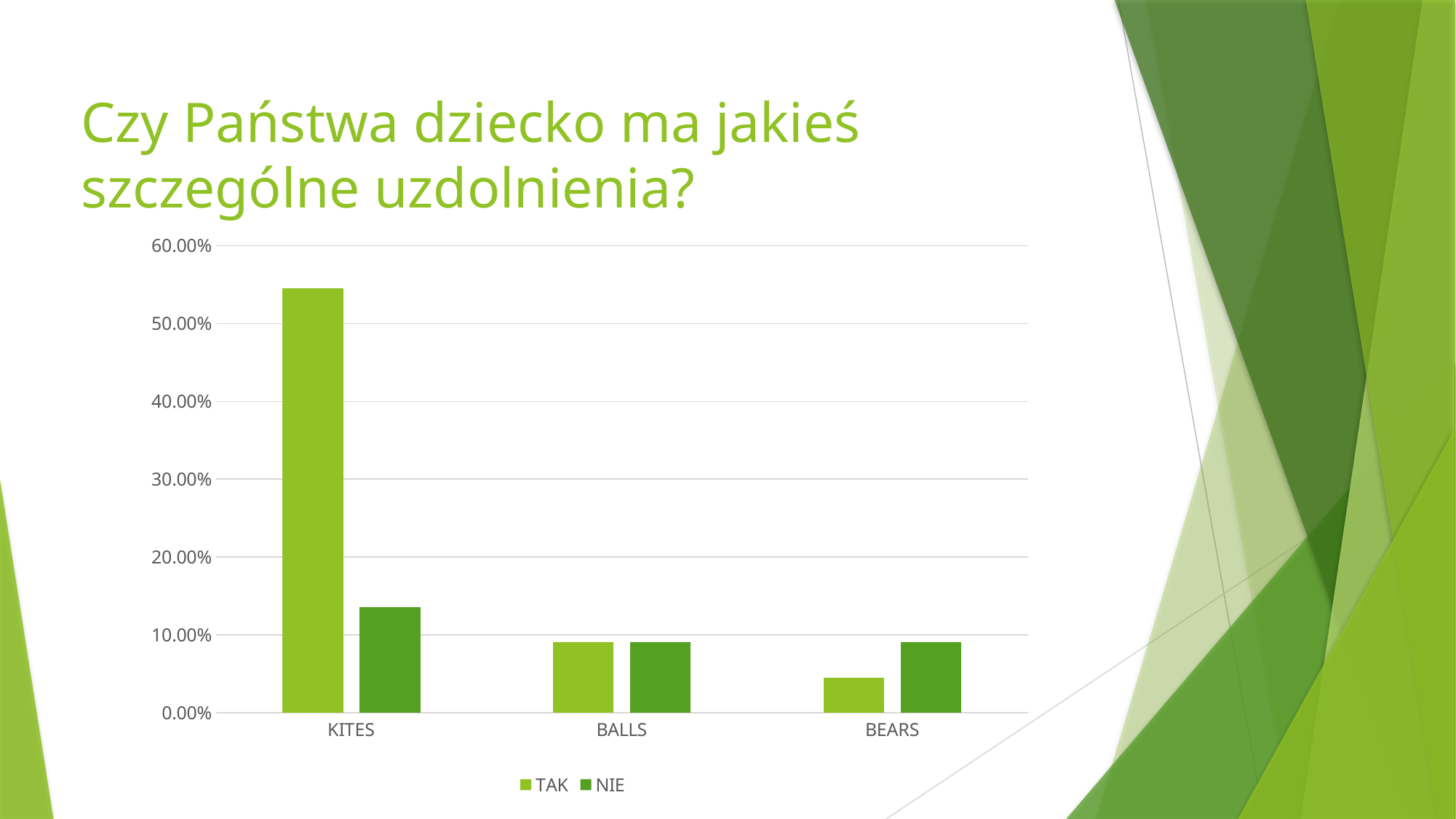
For BEARS, which is larger: the TAK value or the NIE value? NIE Is the NIE value for KITES greater or less than 20.00%? less Is the TAK value for BEARS greater or less than 10.00%? less For KITES, which is larger: the TAK value or the NIE value? TAK Which category has the highest NIE value? KITES What type of chart is shown on the slide? Bar chart How many series does the chart legend list? 2 Is the TAK value for KITES greater or less than 50.00%? greater What are the two series names listed in the chart legend? TAK and NIE Which category has the highest TAK value? KITES Which category has the lowest TAK value? BEARS How many categories are shown on the x axis of the chart? 3